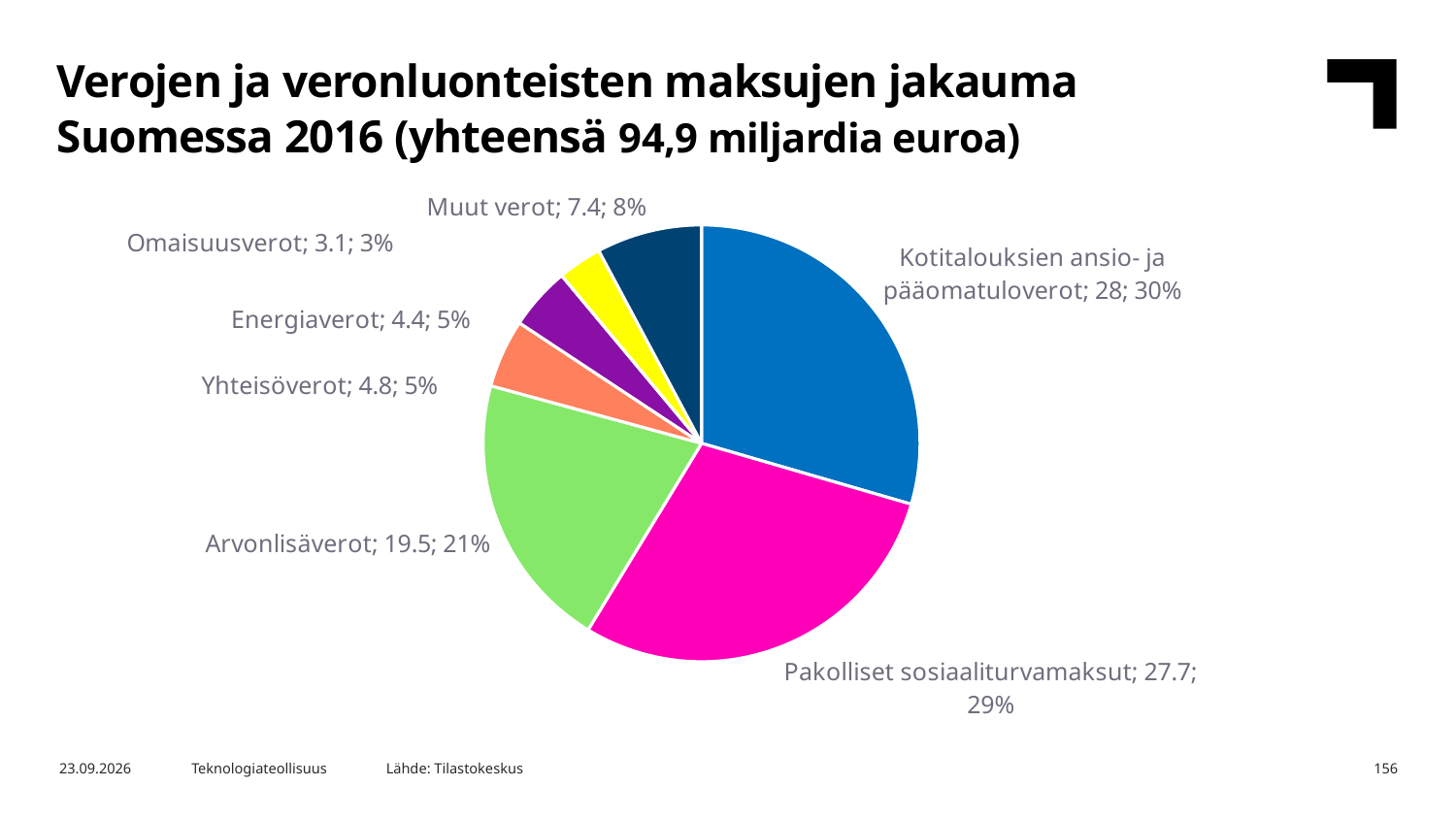
Which category has the smallest slice? Omaisuusverot What is the value for Arvonlisäverot? 19.5 What is the difference between the values for Yhteisöverot and Energiaverot? 0.4 Which is larger, the value for Arvonlisäverot or the value for Muut verot? Arvonlisäverot What kind of chart is shown on the slide? pie chart What share of the pie does Omaisuusverot represent? 3% What share of the pie does Pakolliset sosiaaliturvamaksut represent? 29% Which category has the largest slice? Kotitalouksien ansio- ja pääomatuloverot What is the value for Muut verot? 7.4 What is the title of the chart? Verojen ja veronluonteisten maksujen jakauma Suomessa 2016 (yhteensä 94,9 miljardia euroa) How many slices does the pie chart have? 7 What is the difference between the values for Kotitalouksien ansio- ja pääomatuloverot and Pakolliset sosiaaliturvamaksut? 0.3